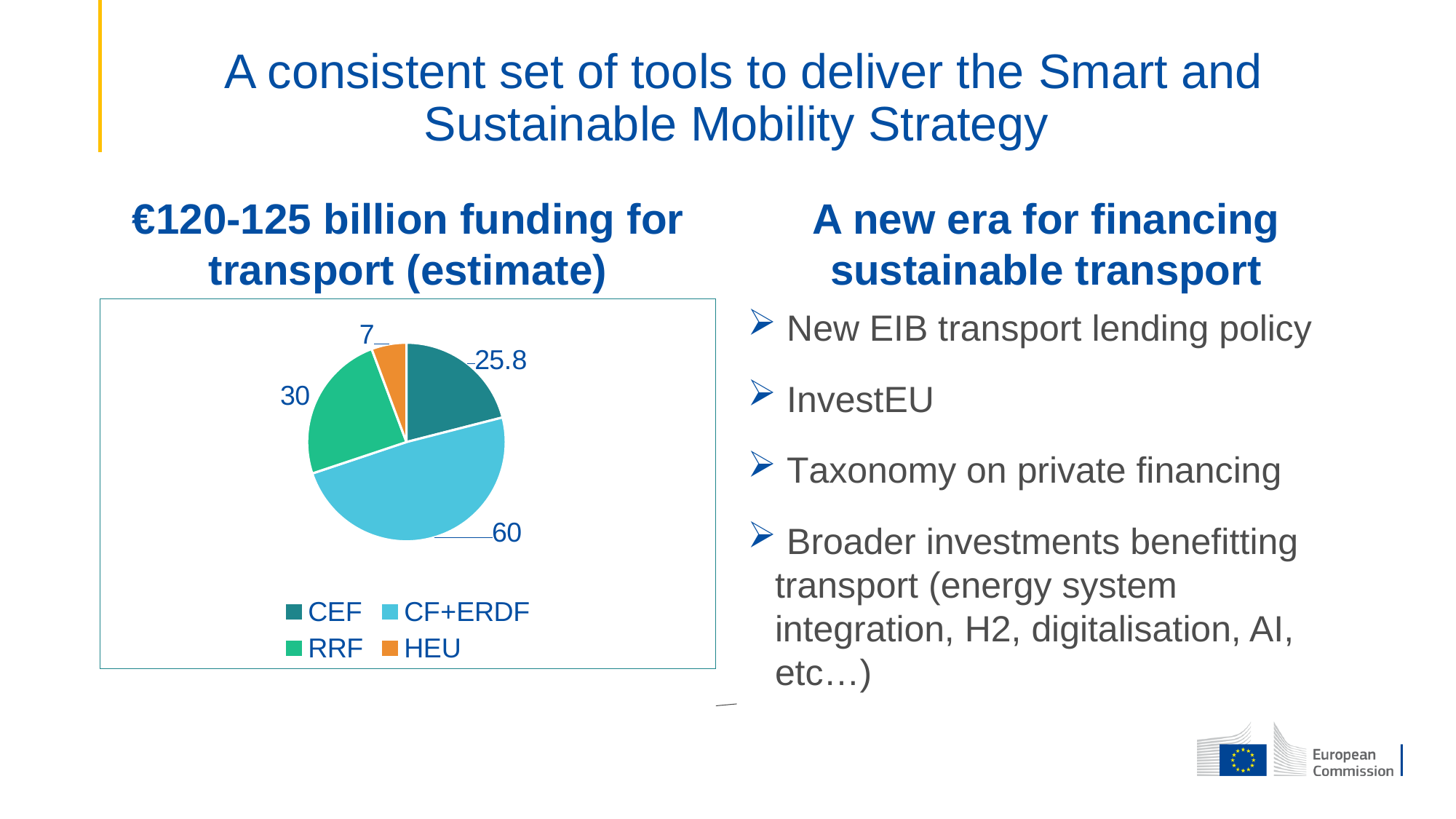
Which category has the smallest slice in the pie chart? HEU What is the value for CEF in the pie chart? 25.8 How many categories does the pie chart show? 4 Which category has the largest slice in the pie chart? CF+ERDF What is the value for CF+ERDF in the pie chart? 60 What is the difference between the values for RRF and CEF? 4.2 What is the total of all the values shown in the pie chart? 122.8 Which is larger, the value for RRF or the value for CEF? RRF What is the value for RRF in the pie chart? 30 What kind of chart is shown on the slide? Pie chart What is the value for HEU in the pie chart? 7 What is the difference between the values for CF+ERDF and RRF? 30